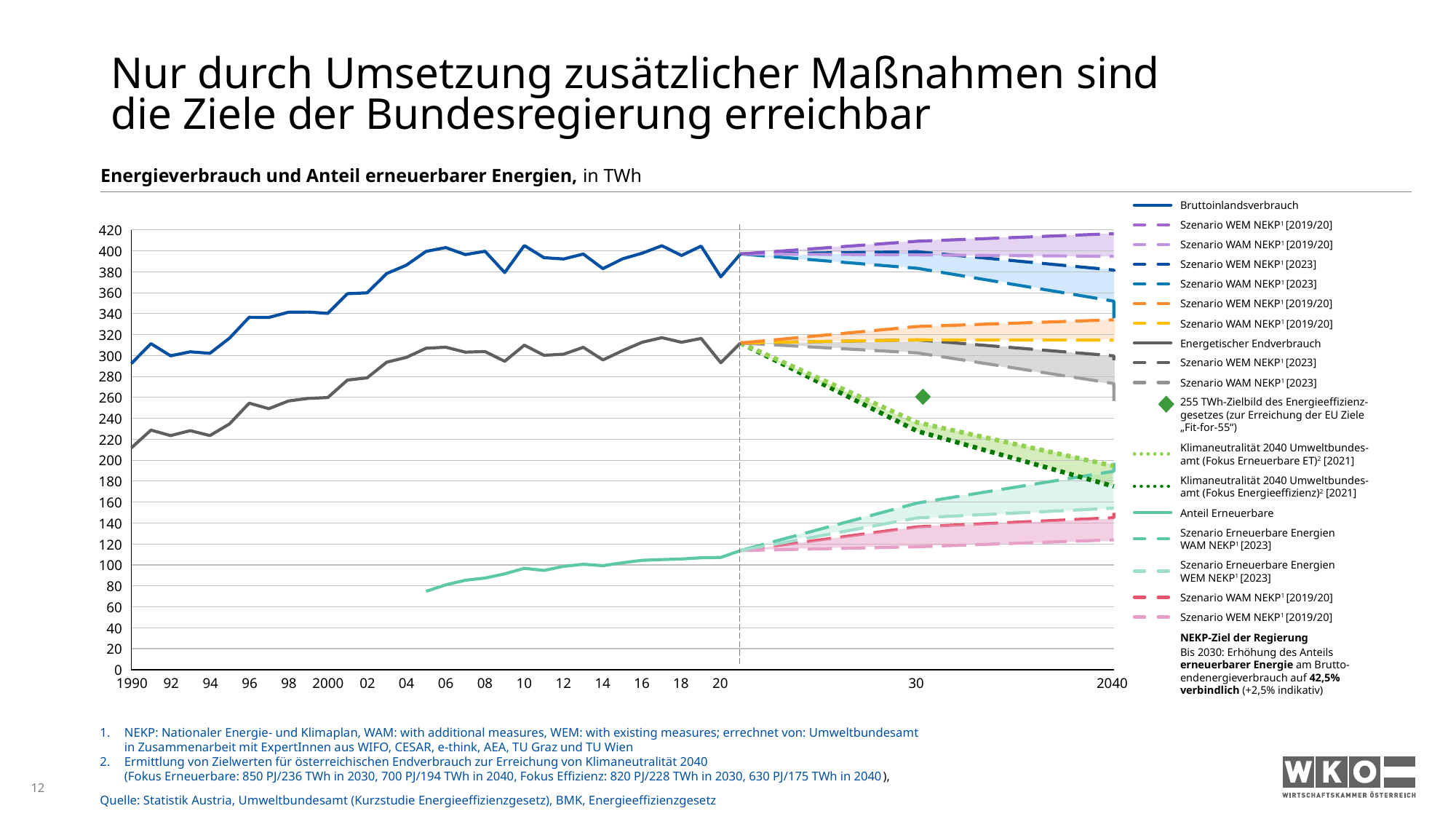
Is the value of Bruttoinlandsverbrauch in 2020 greater or less than 360? greater What value does the green diamond marker in the chart represent, according to the legend? 255 TWh In which year is the green diamond marker for the 255 TWh target placed? 2030 Is the value of Bruttoinlandsverbrauch in 1990 greater or less than 300? less What kind of chart is shown on the slide? line chart Which is higher in 2020, Bruttoinlandsverbrauch or Energetischer Endverbrauch? Bruttoinlandsverbrauch Is the value of Energetischer Endverbrauch in 1990 greater or less than 200? greater Does the Bruttoinlandsverbrauch line overall rise or fall between 1990 and 2020? rise How many entries does the chart legend list? 18 Does the Anteil Erneuerbare line rise or fall between 2005 and 2020? rise What is the title of the chart? Energieverbrauch und Anteil erneuerbarer Energien, in TWh